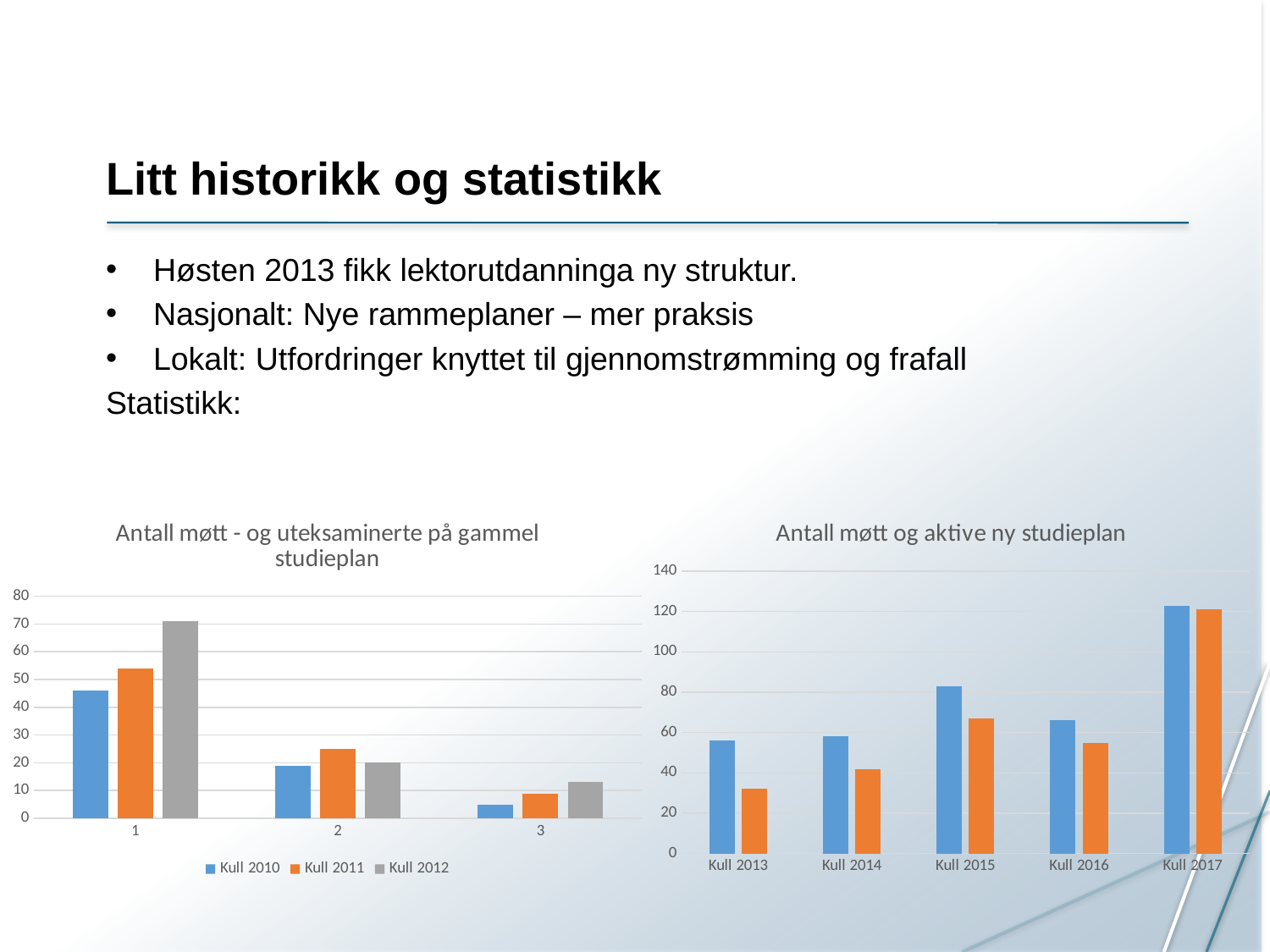
In the left chart 'Antall møtt - og uteksaminerte på gammel studieplan', how many series does the legend list? 3 In the right chart 'Antall møtt og aktive ny studieplan', which category has the tallest blue bar? Kull 2017 What is the title of the right chart on the slide? Antall møtt og aktive ny studieplan In the right chart 'Antall møtt og aktive ny studieplan', how many categories are shown on the x axis? 5 In the right chart 'Antall møtt og aktive ny studieplan', is the blue bar for Kull 2015 greater or less than 60? greater In the right chart 'Antall møtt og aktive ny studieplan', is the orange bar for Kull 2013 greater or less than 40? less In the right chart 'Antall møtt og aktive ny studieplan', which category has the shortest orange bar? Kull 2013 In the left chart 'Antall møtt - og uteksaminerte på gammel studieplan', do the Kull 2010 values rise or fall from category 1 to category 3? fall In the left chart 'Antall møtt - og uteksaminerte på gammel studieplan', which is larger for category 1: Kull 2010 or Kull 2012? Kull 2012 In the left chart 'Antall møtt - og uteksaminerte på gammel studieplan', is the Kull 2012 value for category 1 greater or less than 60? greater What kind of chart is the left chart titled 'Antall møtt - og uteksaminerte på gammel studieplan'? bar chart In the left chart 'Antall møtt - og uteksaminerte på gammel studieplan', which category has the highest Kull 2012 value? 1